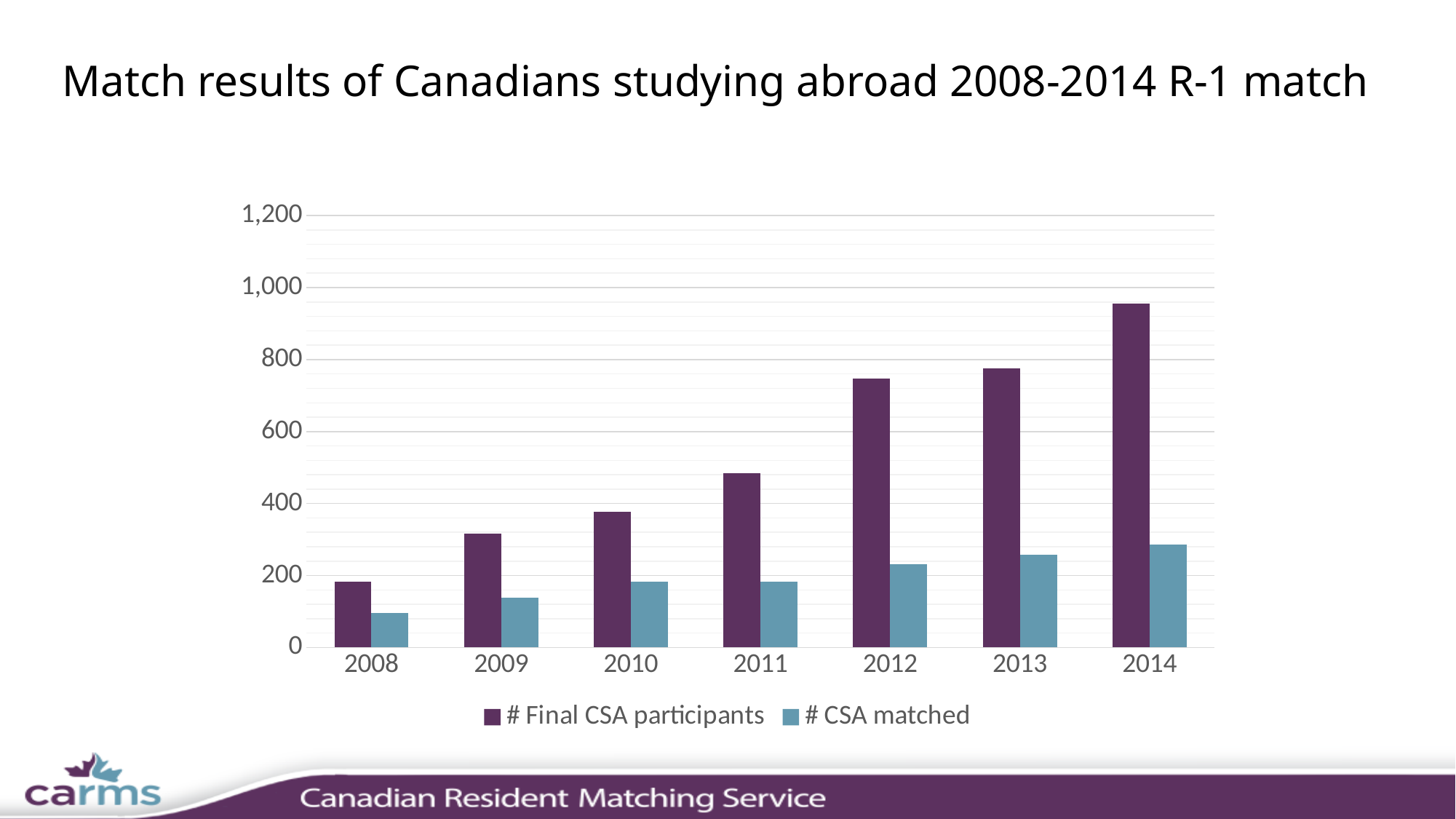
Which year has the lowest number of CSA matched? 2008 Is the number of final CSA participants in 2014 greater or less than 800? greater What kind of chart is shown on the slide? bar chart Do the number of final CSA participants rise or fall from 2008 to 2014? rise Which year has the highest number of final CSA participants? 2014 Which is larger: the number of final CSA participants in 2011 or in 2009? 2011 Which year has the highest number of CSA matched? 2014 How many series does the legend list? 2 Is the number of final CSA participants in 2008 greater or less than 200? less Is the number of CSA matched in 2014 greater or less than 200? greater Which year has the lowest number of final CSA participants? 2008 How many years are shown on the x axis? 7